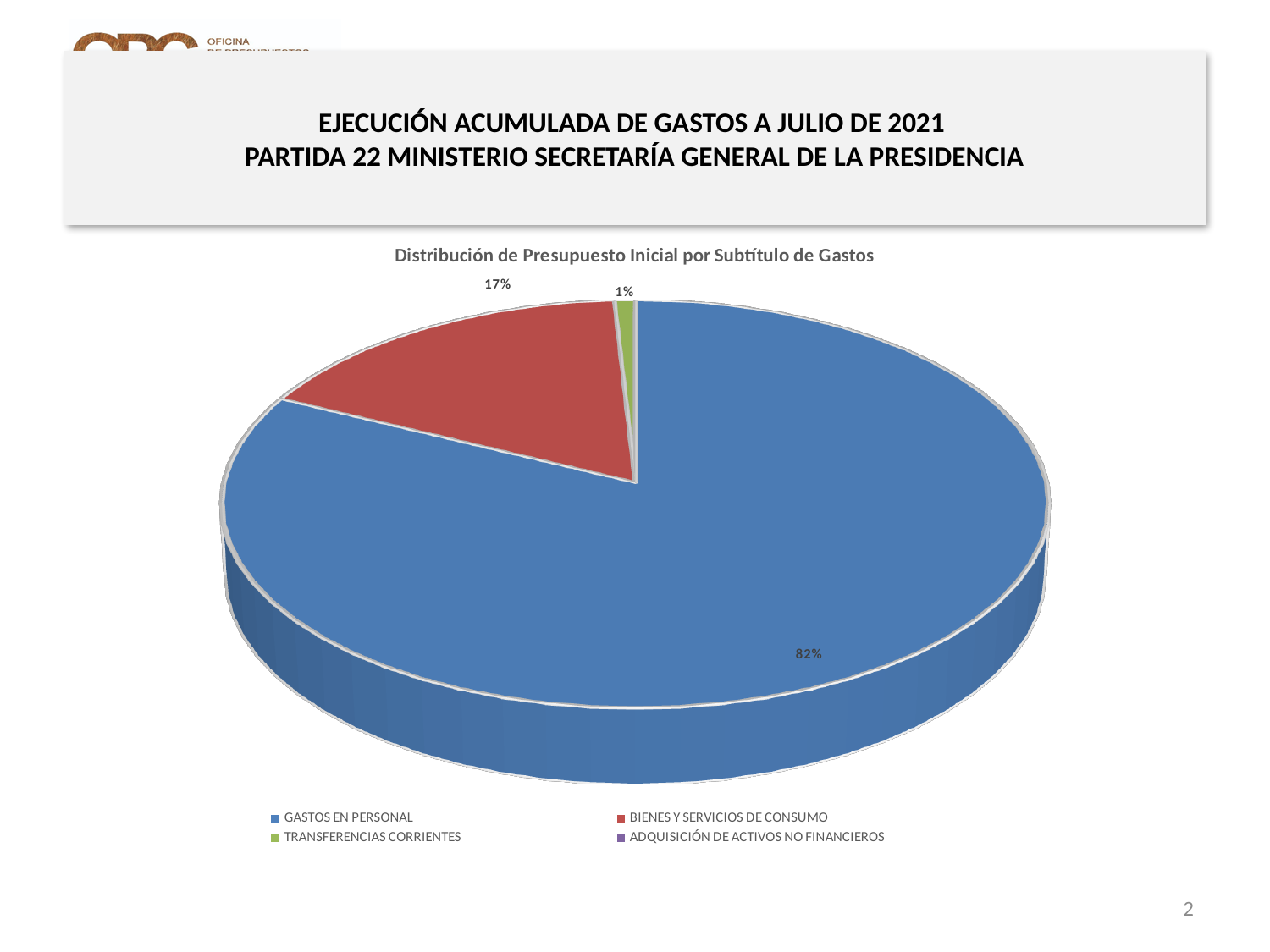
What is the title of the chart? Distribución de Presupuesto Inicial por Subtítulo de Gastos Is the share for GASTOS EN PERSONAL greater or less than 50%? greater What percentage is shown for TRANSFERENCIAS CORRIENTES? 1% What colour is the slice for BIENES Y SERVICIOS DE CONSUMO? Red How many entries does the legend list? 4 What percentage is shown for BIENES Y SERVICIOS DE CONSUMO? 17% Which category has the largest slice of the pie? GASTOS EN PERSONAL What kind of chart is shown on the slide? Pie chart What is the difference in percentage points between GASTOS EN PERSONAL and BIENES Y SERVICIOS DE CONSUMO? 65 percentage points Which is larger, the slice for BIENES Y SERVICIOS DE CONSUMO or the slice for TRANSFERENCIAS CORRIENTES? BIENES Y SERVICIOS DE CONSUMO What share of the pie does GASTOS EN PERSONAL represent? 82%